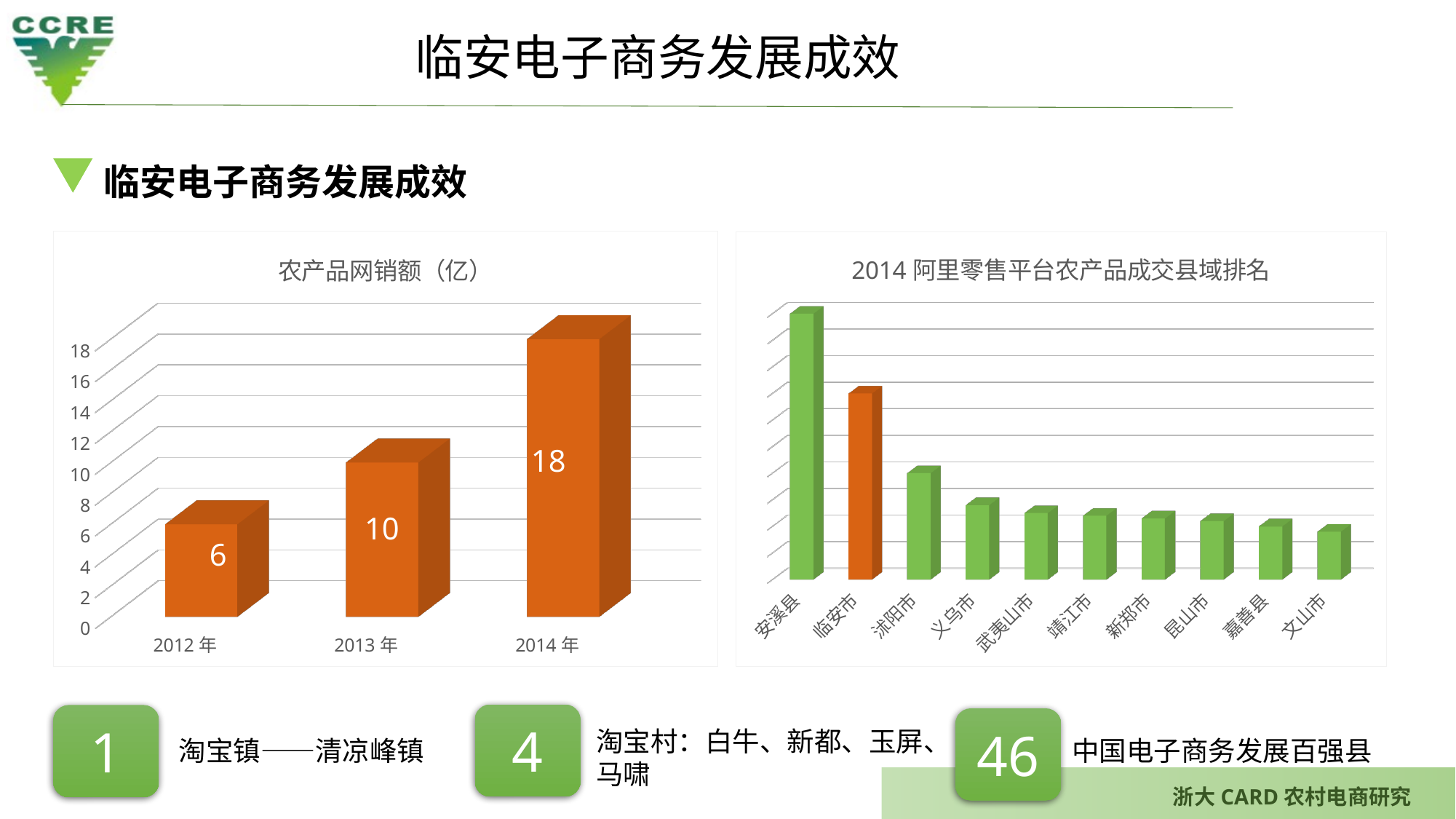
In the chart titled 农产品网销额（亿）, what is the difference between the values for 2014 年 and 2012 年? 12 In the chart titled 2014 阿里零售平台农产品成交县域排名, which bar is coloured orange instead of green? 临安市 In the chart titled 农产品网销额（亿）, what is the value for 2012 年? 6 In the chart titled 农产品网销额（亿）, do the values rise or fall from 2012 年 to 2014 年? rise What kind of chart is the chart titled 2014 阿里零售平台农产品成交县域排名? bar chart In the chart titled 农产品网销额（亿）, what is the value for 2013 年? 10 In the chart titled 农产品网销额（亿）, what is the value for 2014 年? 18 In the chart titled 农产品网销额（亿）, which year has the highest value? 2014 年 In the chart titled 2014 阿里零售平台农产品成交县域排名, which county has the lowest bar? 文山市 In the chart titled 农产品网销额（亿）, how many years are plotted? 3 In the chart titled 2014 阿里零售平台农产品成交县域排名, how many counties are shown? 10 In the chart titled 2014 阿里零售平台农产品成交县域排名, which county has the highest bar? 安溪县